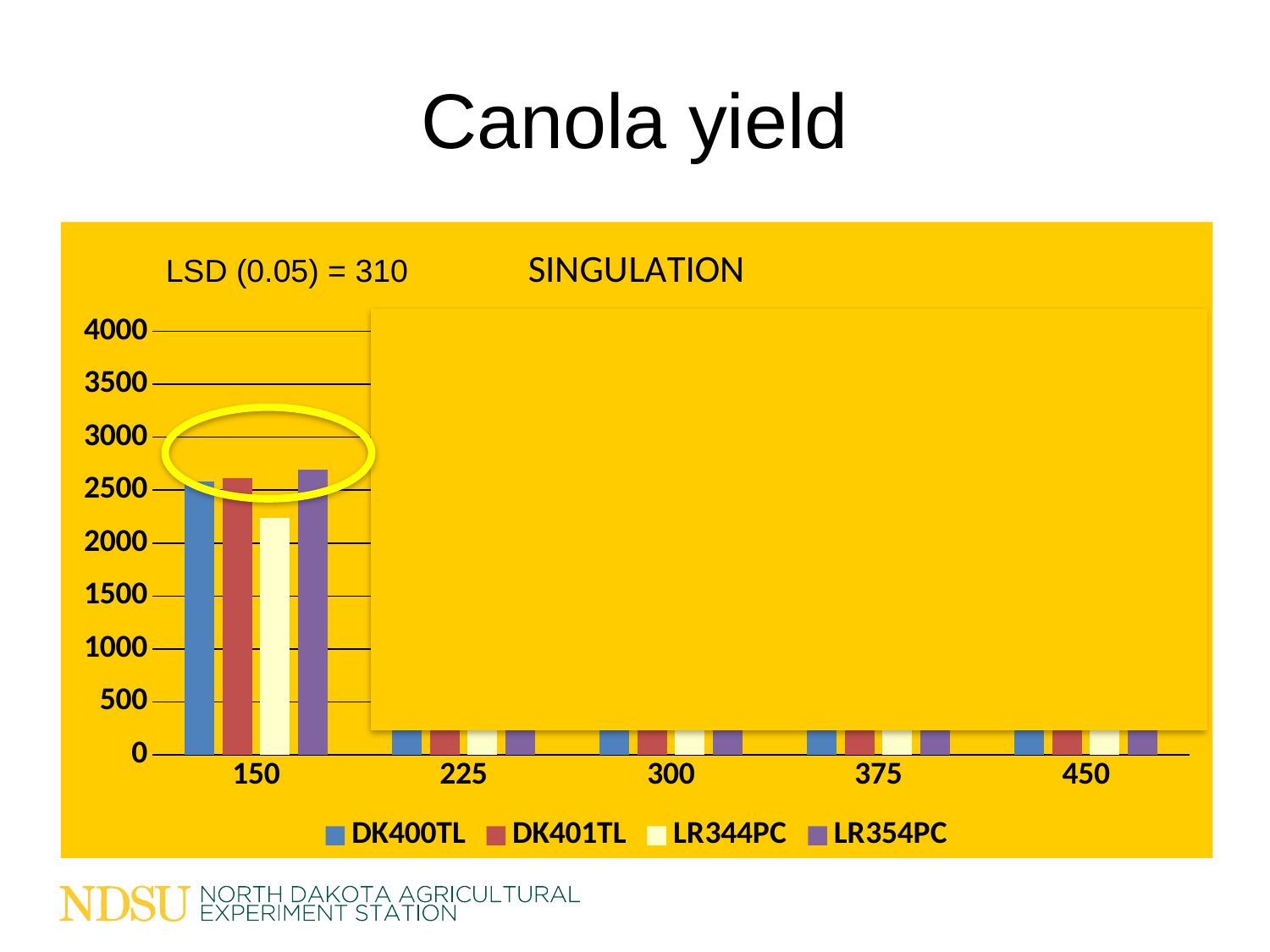
How many categories are shown on the x axis? 5 What is the title of the slide containing the chart? Canola yield At the 150 category, which is larger: LR354PC or LR344PC? LR354PC Is the value for LR344PC at 150 greater or less than 2500? less Is the value for DK401TL at 150 greater or less than 2000? greater At the 150 category, which is larger: DK400TL or LR344PC? DK400TL Which series are listed in the legend? DK400TL, DK401TL, LR344PC, LR354PC How many series does the legend list? 4 Is the value for LR354PC at 150 greater or less than 2500? greater What kind of chart is shown on the slide? bar chart At the 150 category, which series has the lowest value? LR344PC